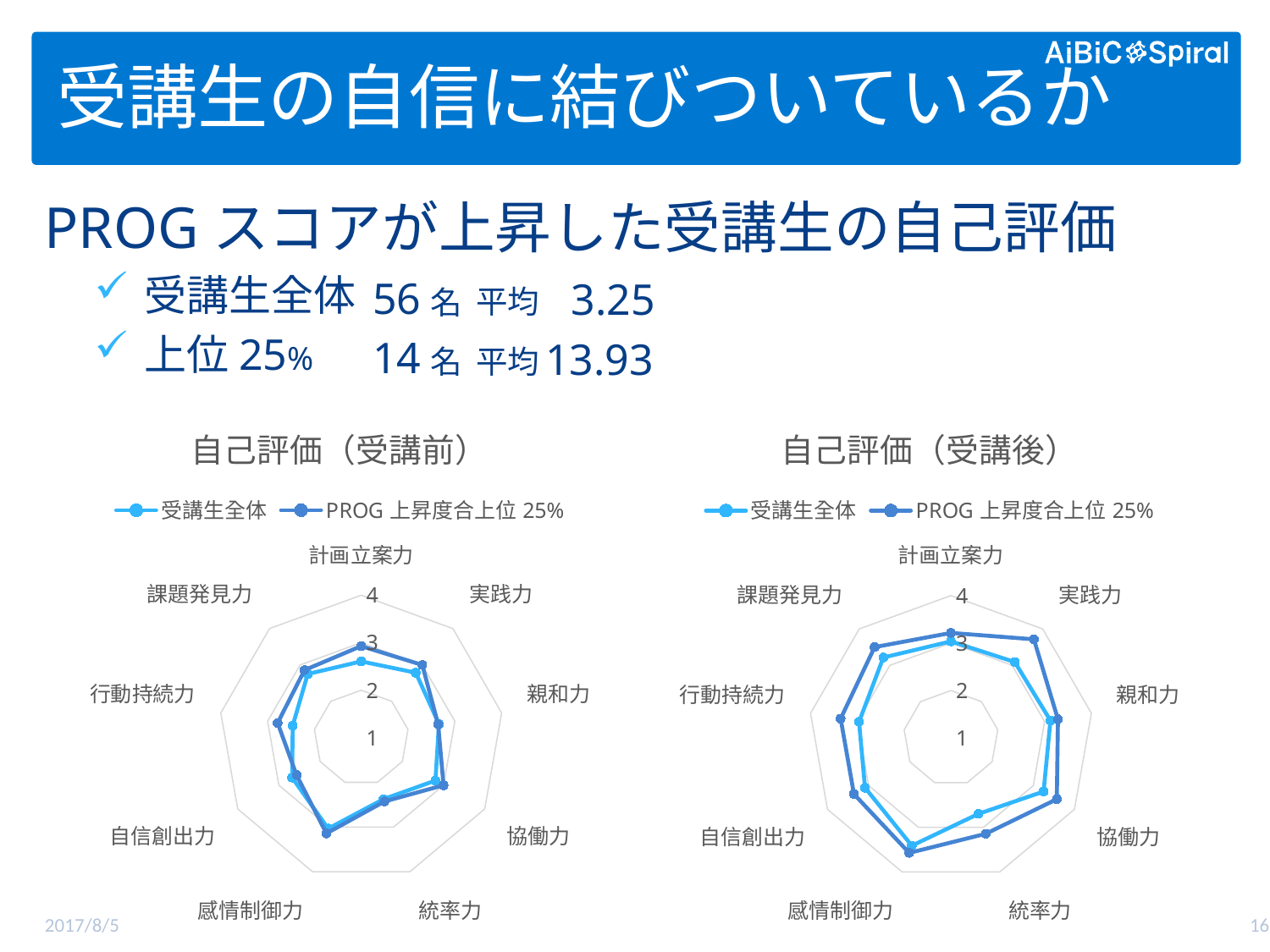
In the 自己評価（受講前） chart, is the value of 受講生全体 for 親和力 greater or less than 3? less In the 自己評価（受講後） chart, is the value of PROG 上昇度合上位 25% for 自信創出力 greater or less than 3? greater In the 自己評価（受講前） chart, which category has the highest value for 受講生全体? 感情制御力 What is the title of the chart on the right side of the slide? 自己評価（受講後） In the 自己評価（受講前） chart, is the value of 受講生全体 for 統率力 greater or less than 3? less How many series does the legend of the 自己評価（受講後） chart list? 2 How many categories (axes) does the 自己評価（受講前） chart have? 9 What kind of chart is the 自己評価（受講前） chart? radar chart In the 自己評価（受講後） chart, which series has the larger value for 課題発見力, 受講生全体 or PROG 上昇度合上位 25%? PROG 上昇度合上位 25%